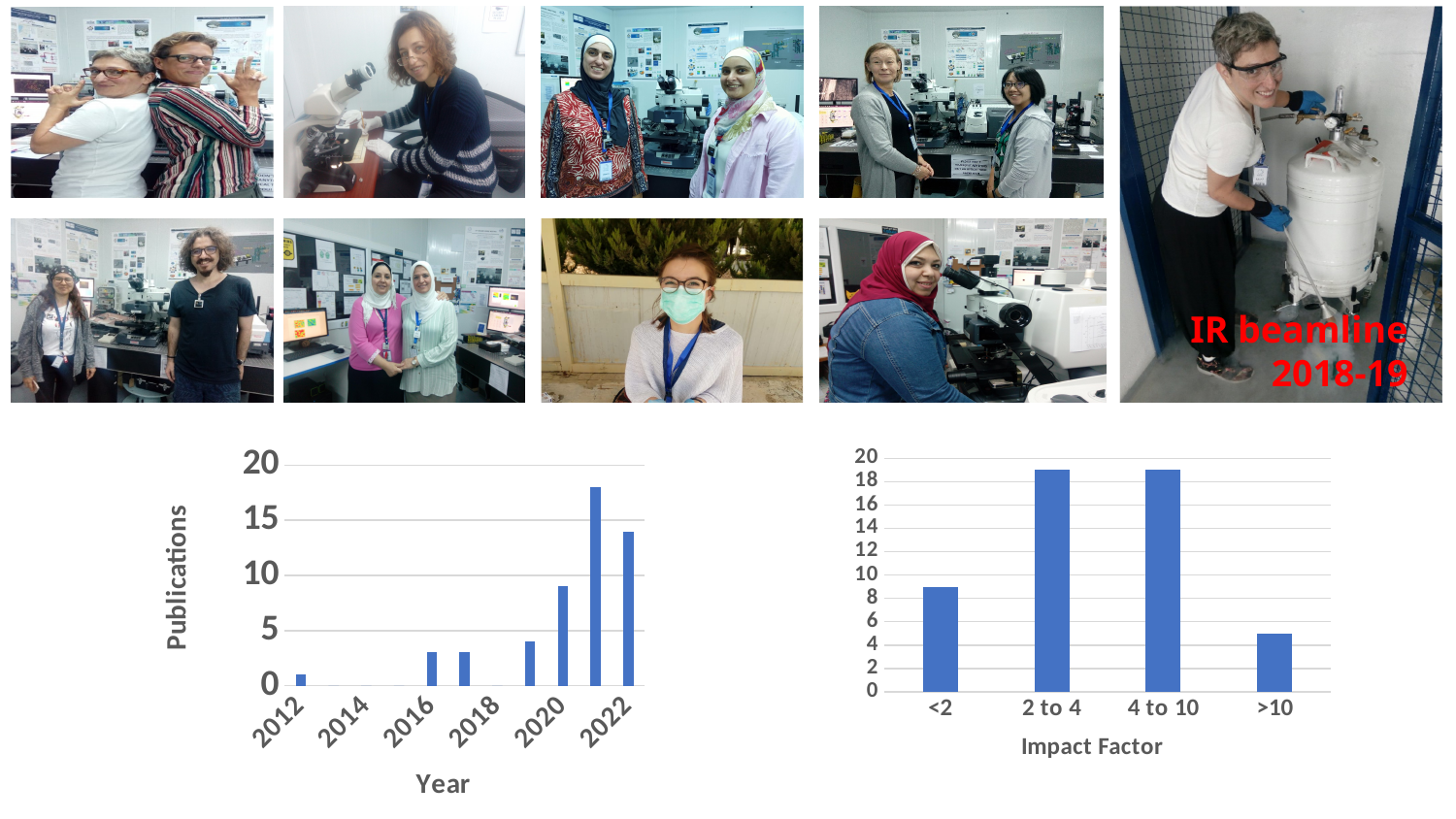
In the Publications by Year chart on the left, how many bars are plotted? 7 What kind of chart is the chart on the left with the y-axis labelled Publications? bar chart In the Impact Factor chart, is the value for the >10 category greater or less than 4? greater In the Impact Factor chart, is the value for the 2 to 4 category greater or less than 10? greater In the Impact Factor chart, how many impact factor categories are shown on the x axis? 4 In the Impact Factor chart, is the value for the <2 category greater or less than 10? less In the Impact Factor chart, which category has the lowest bar? >10 What is the x-axis title of the chart on the right? Impact Factor In the Impact Factor chart, which has the larger value, <2 or >10? <2 In the Publications by Year chart on the left, do the number of publications generally rise or fall from 2012 to 2022? rise What kind of chart is the chart on the right with the x-axis labelled Impact Factor? bar chart